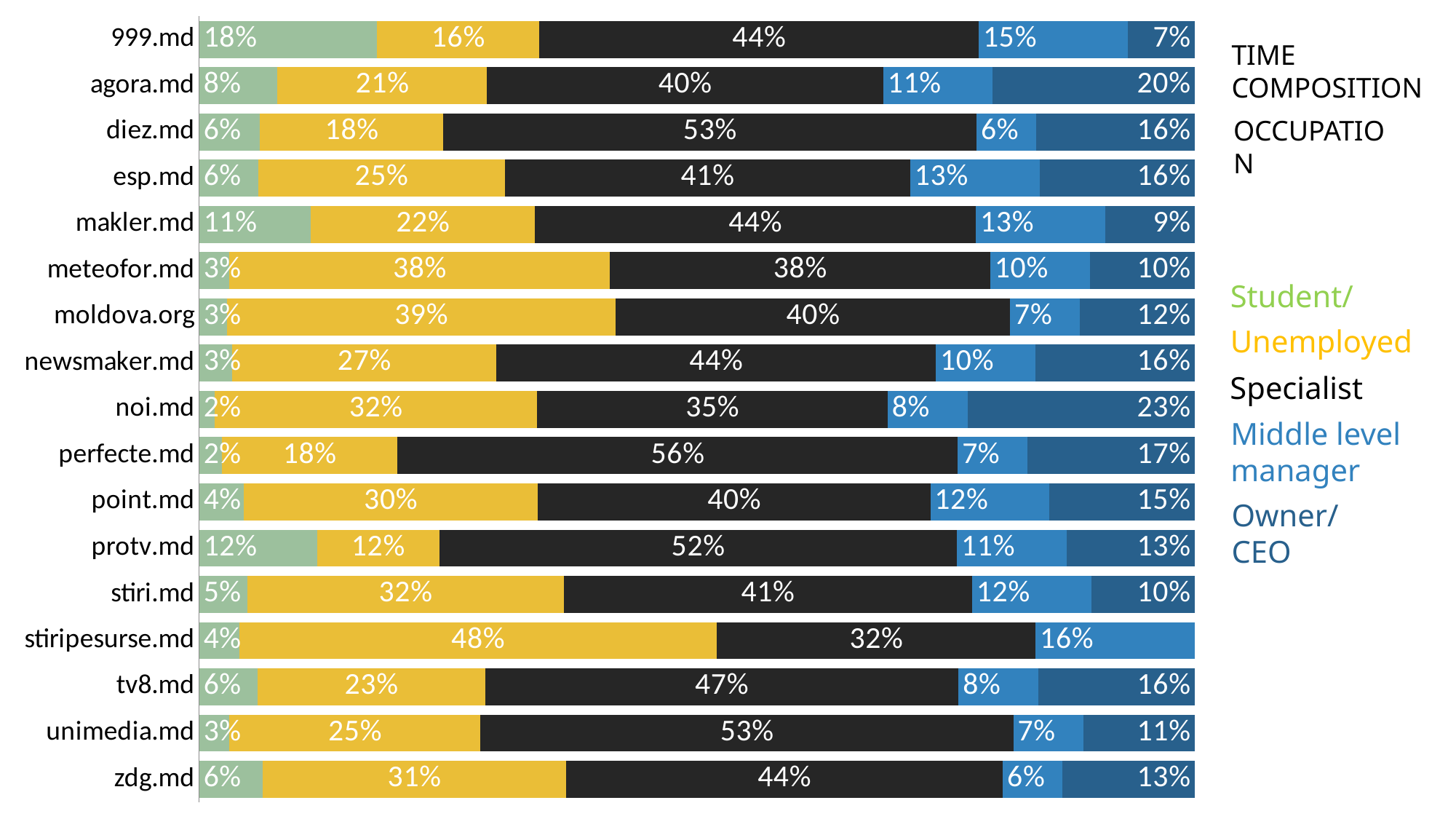
What is the Owner/CEO share for noi.md? 23% How many websites (categories) are shown in the chart? 17 What type of chart is shown on the slide? Stacked bar chart Which website has the lowest Specialist share? stiripesurse.md What is the Specialist share for perfecte.md? 56% What is the Unemployed share for stiripesurse.md? 48% Which is larger: the Owner/CEO share for agora.md or for 999.md? agora.md Which website has the highest Specialist share? perfecte.md What colour represents the Specialist series? Black Which website has the highest Student share? 999.md How many series does the legend list? 5 What is the difference between the Specialist share and the Student share for 999.md? 26 percentage points